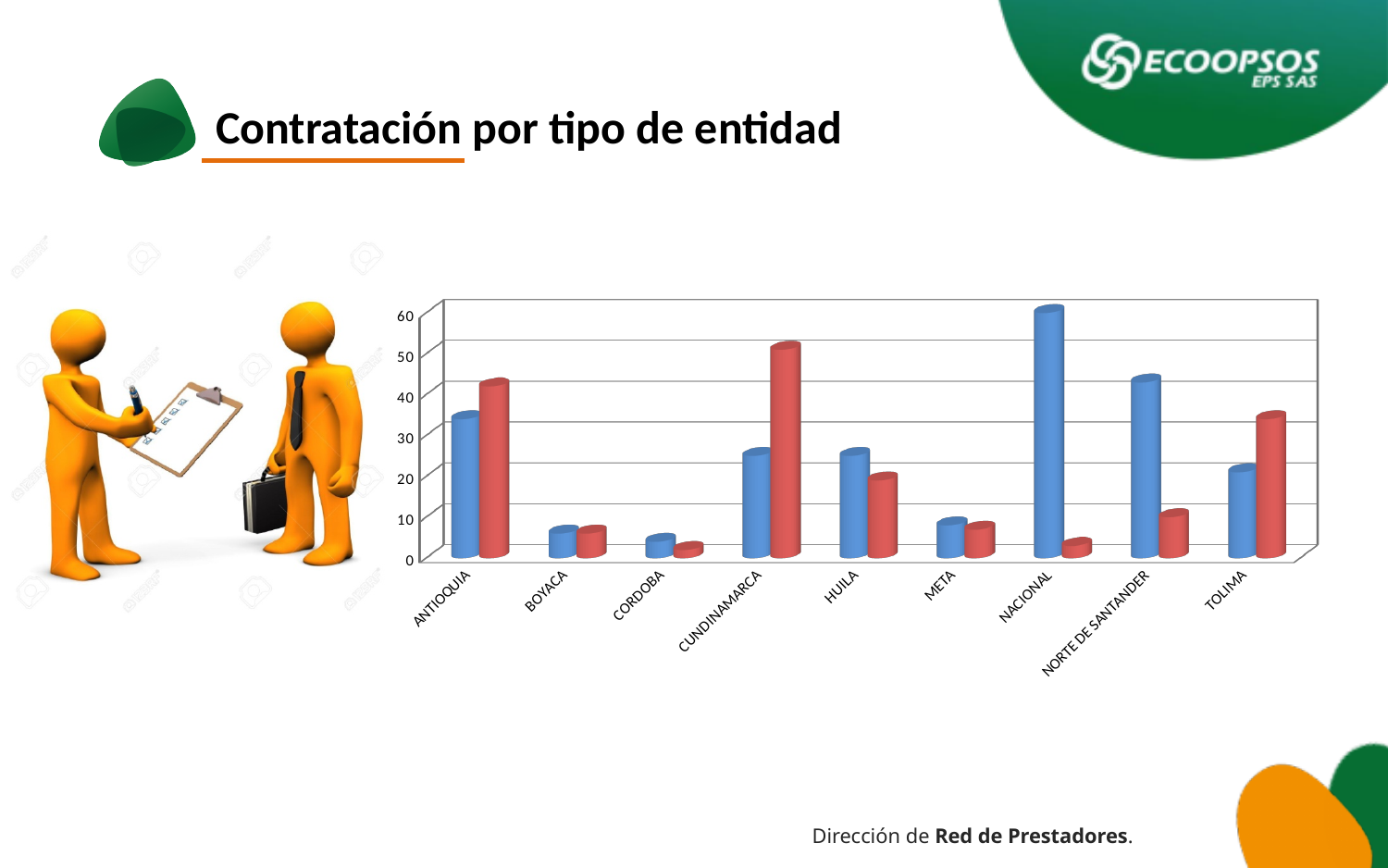
How many data series (bar colours) are plotted for each category? 2 Is the red bar for NORTE DE SANTANDER greater or less than 20? less Which category has the tallest red bar? CUNDINAMARCA How many categories are shown on the x axis of the chart? 9 Which category has the shortest red bar? CORDOBA Is the blue bar for NACIONAL greater or less than 50? greater For NORTE DE SANTANDER, which bar is taller, the blue one or the red one? blue For ANTIOQUIA, which bar is taller, the blue one or the red one? red What kind of chart is shown on the slide? bar chart Which category has the tallest blue bar? NACIONAL Is the red bar for CUNDINAMARCA greater or less than 40? greater What is the title of the slide containing the chart? Contratación por tipo de entidad